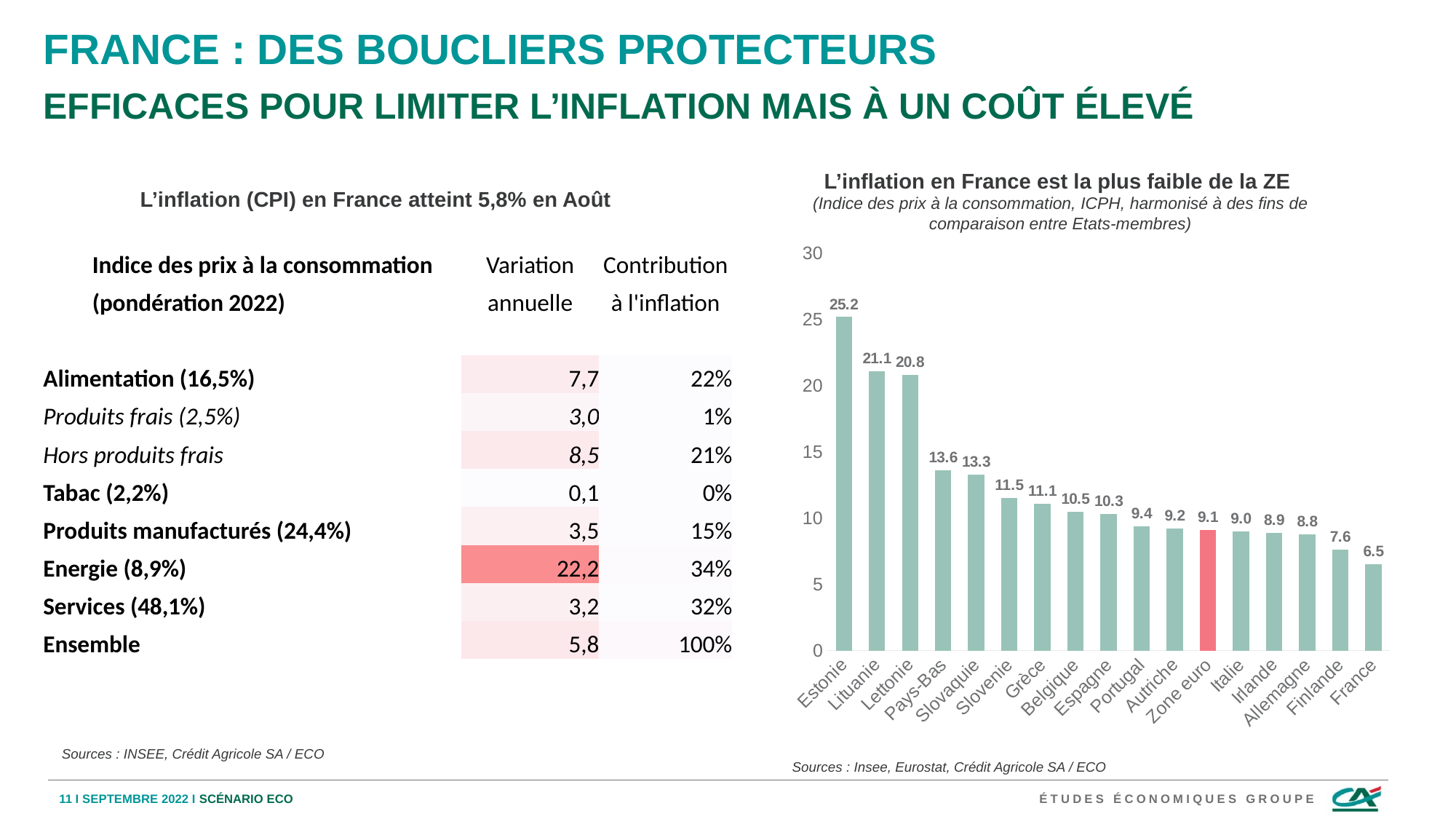
What type of chart is shown on the right of the slide? Bar chart What is the value shown for Estonie in the bar chart? 25.2 What is the value shown for Zone euro in the bar chart? 9.1 Which bar in the chart is highlighted in a different colour (red) from the others? Zone euro How many countries or regions are shown in the bar chart? 17 Which country has the lowest value in the bar chart? France What is the value shown for Allemagne in the bar chart? 8.8 What is the difference between the values for Zone euro and France in the bar chart? 2.6 What is the value shown for France in the bar chart? 6.5 Which country has the highest value in the bar chart? Estonie Which has a larger value in the bar chart, Pays-Bas or Slovenie? Pays-Bas What is the difference between the values for Estonie and France in the bar chart? 18.7